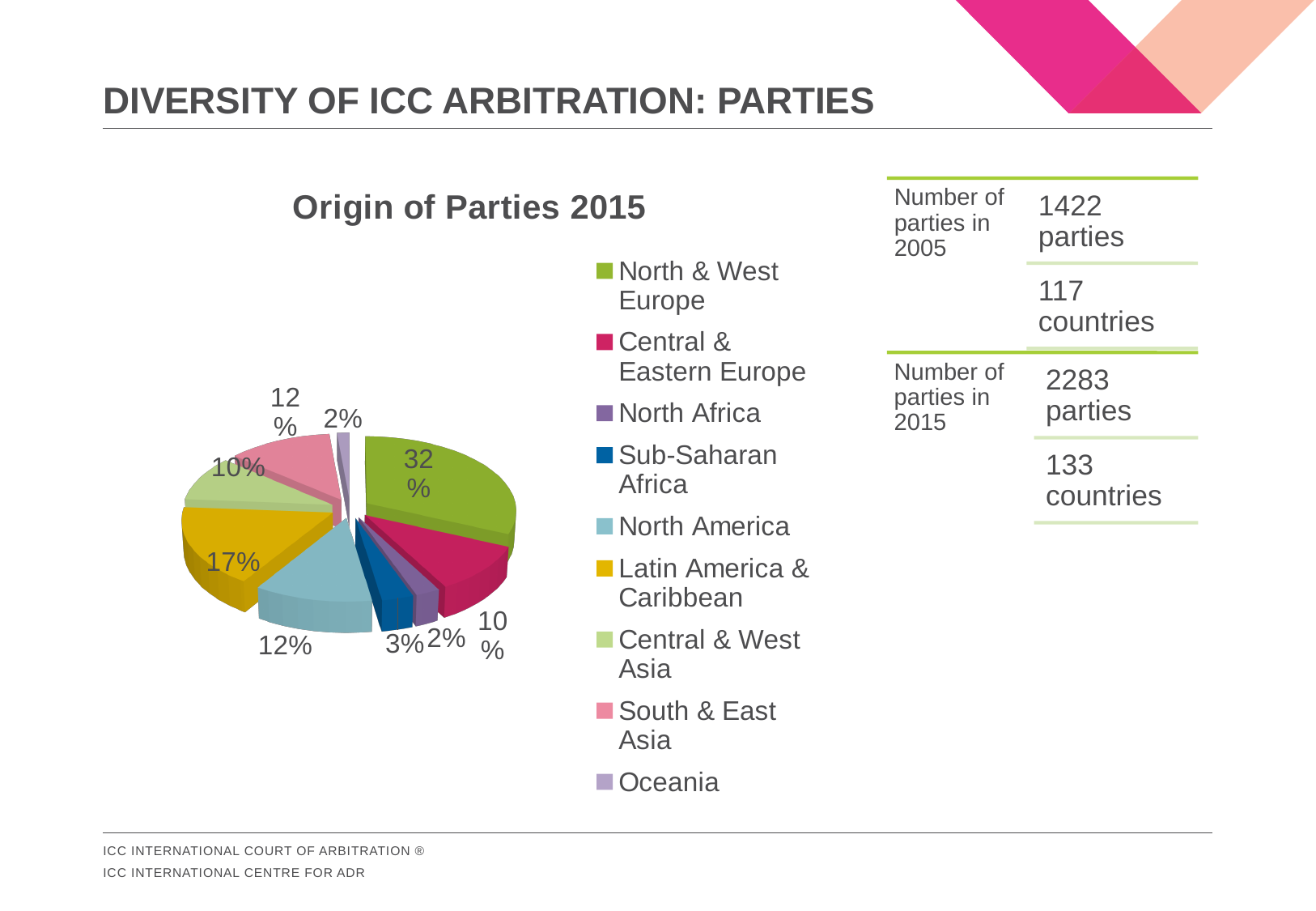
Which has the larger share of parties in 2015, Central & Eastern Europe or Latin America & Caribbean? Latin America & Caribbean What share of parties in 2015 came from Latin America & Caribbean? 17% Which region has the largest share of parties in 2015? North & West Europe What is the title of the chart? Origin of Parties 2015 How many categories does the legend of the pie chart list? 9 What share of parties in 2015 came from North & West Europe? 32% What type of chart is shown on the slide? pie chart Which colour represents Oceania in the pie chart? lavender (light purple) What share of parties in 2015 came from North America? 12% What share of parties in 2015 came from Central & West Asia? 10% What share of parties in 2015 came from Sub-Saharan Africa? 3% What is the difference in percentage points between the North & West Europe share and the Latin America & Caribbean share? 15